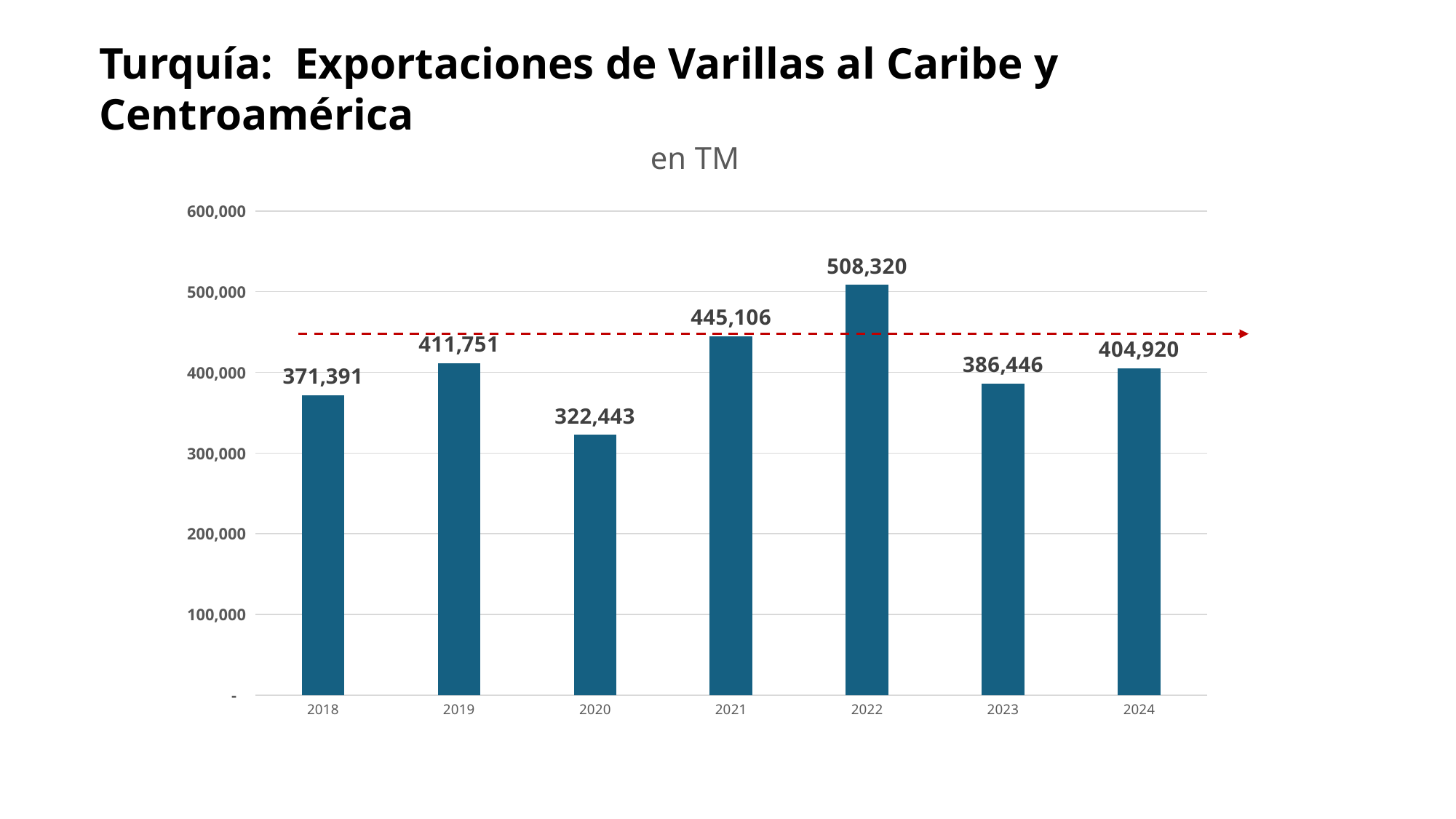
What is the difference between the values for 2022 and 2020? 185,877 How many years are shown on the x axis? 7 What is the value for 2022? 508,320 What is the difference between the values for 2024 and 2023? 18,474 Do the values rise or fall from 2022 to 2023? fall Which is larger, the value for 2019 or the value for 2021? 2021 Which year has the highest value? 2022 What kind of chart is shown on the slide? bar chart Is the value for 2022 greater or less than 500,000? greater Which year has the lowest value? 2020 What is the value for 2024? 404,920 What is the value for 2018? 371,391